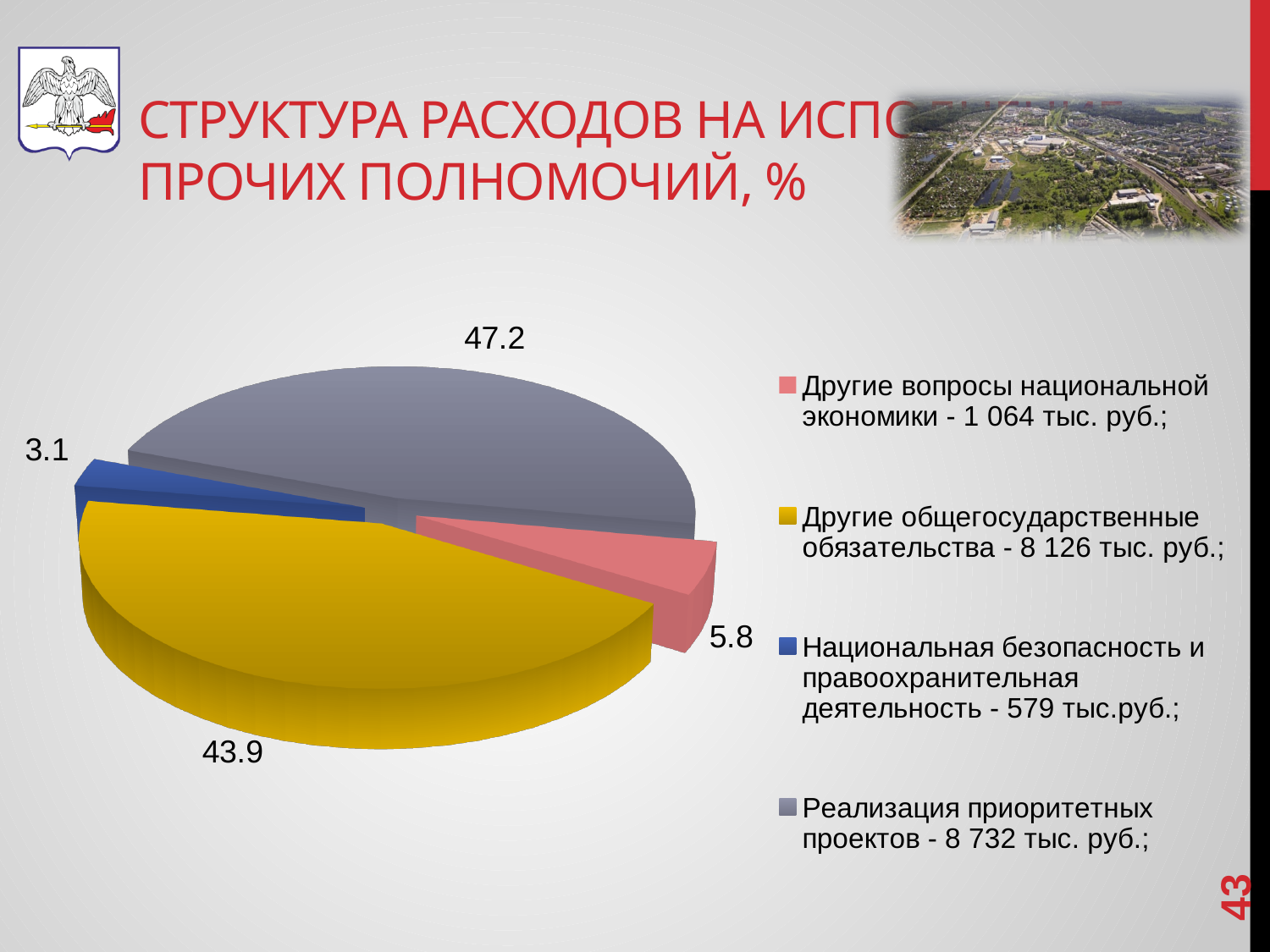
Which is larger: the share for "Другие вопросы национальной экономики" or the share for "Национальная безопасность и правоохранительная деятельность"? Другие вопросы национальной экономики How many entries does the legend of the pie chart list? 4 What percentage is shown for "Другие общегосударственные обязательства"? 43.9 What percentage is shown for "Реализация приоритетных проектов"? 47.2 What type of chart is shown on the slide? pie chart Which category has the largest share of the pie? Реализация приоритетных проектов What percentage is shown for "Национальная безопасность и правоохранительная деятельность"? 3.1 What amount in thousand rubles does the legend give for "Реализация приоритетных проектов"? 8 732 тыс. руб. What percentage is shown for "Другие вопросы национальной экономики"? 5.8 How many slices does the pie chart have? 4 What is the difference in percentage points between "Реализация приоритетных проектов" and "Другие общегосударственные обязательства"? 3.3 Which category has the smallest share of the pie? Национальная безопасность и правоохранительная деятельность